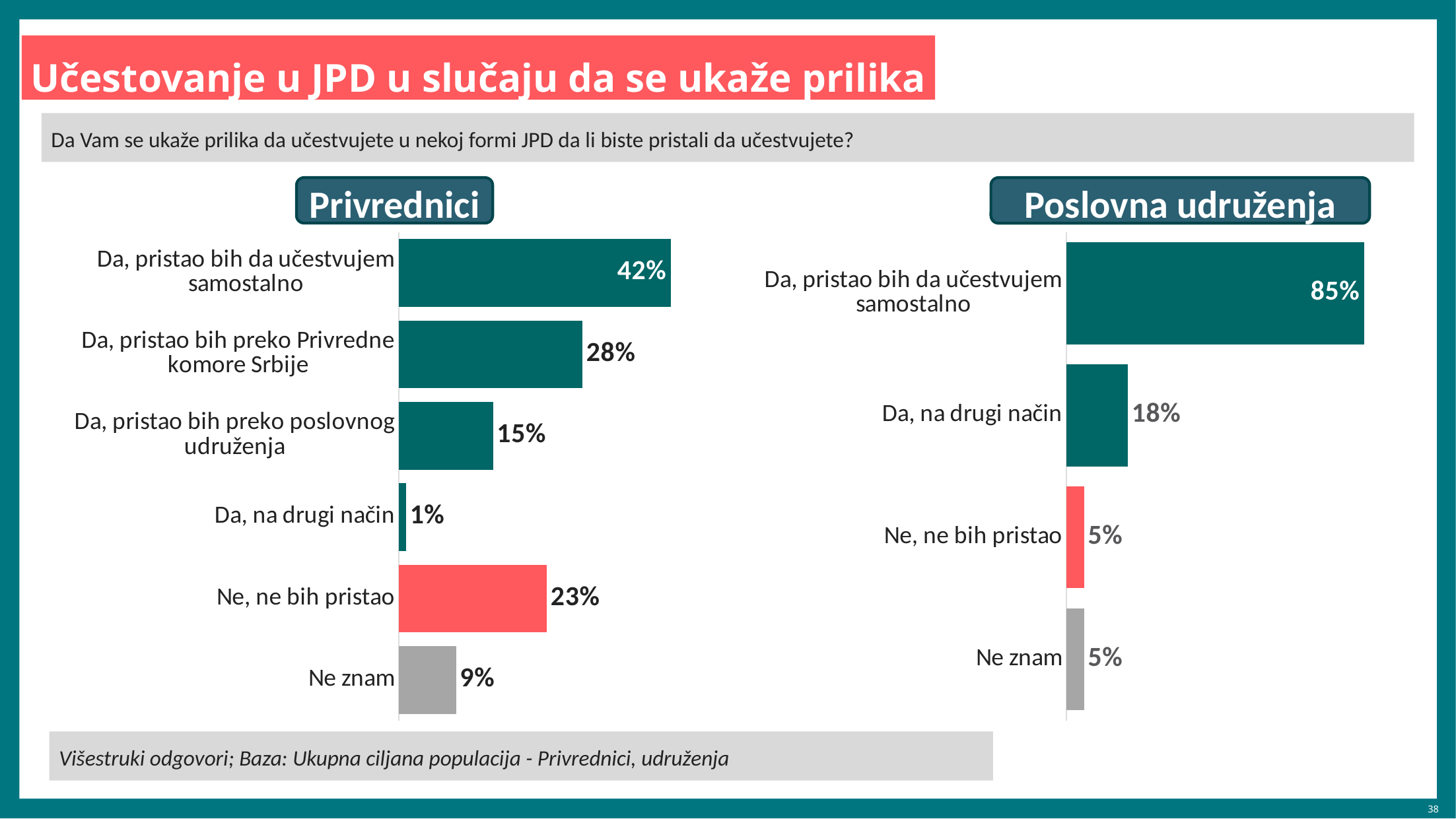
How many categories does the Privrednici chart show? 6 In the Privrednici chart, what is the value for "Ne, ne bih pristao"? 23% In the Poslovna udruženja chart, what is the value for "Da, na drugi način"? 18% In the Poslovna udruženja chart, which category has the highest value? Da, pristao bih da učestvujem samostalno In the Privrednici chart, what is the difference between "Da, pristao bih da učestvujem samostalno" and "Da, pristao bih preko Privredne komore Srbije"? 14% In the Privrednici chart, what colour is the bar for "Ne, ne bih pristao"? Red In the Privrednici chart, what is the value for "Da, pristao bih da učestvujem samostalno"? 42% What kind of chart is the Poslovna udruženja chart? Bar chart In the Privrednici chart, which is larger: "Ne, ne bih pristao" or "Da, pristao bih preko poslovnog udruženja"? Ne, ne bih pristao How many categories does the Poslovna udruženja chart show? 4 In the Poslovna udruženja chart, what is the difference between "Da, pristao bih da učestvujem samostalno" and "Da, na drugi način"? 67% In the Privrednici chart, which category has the lowest value? Da, na drugi način